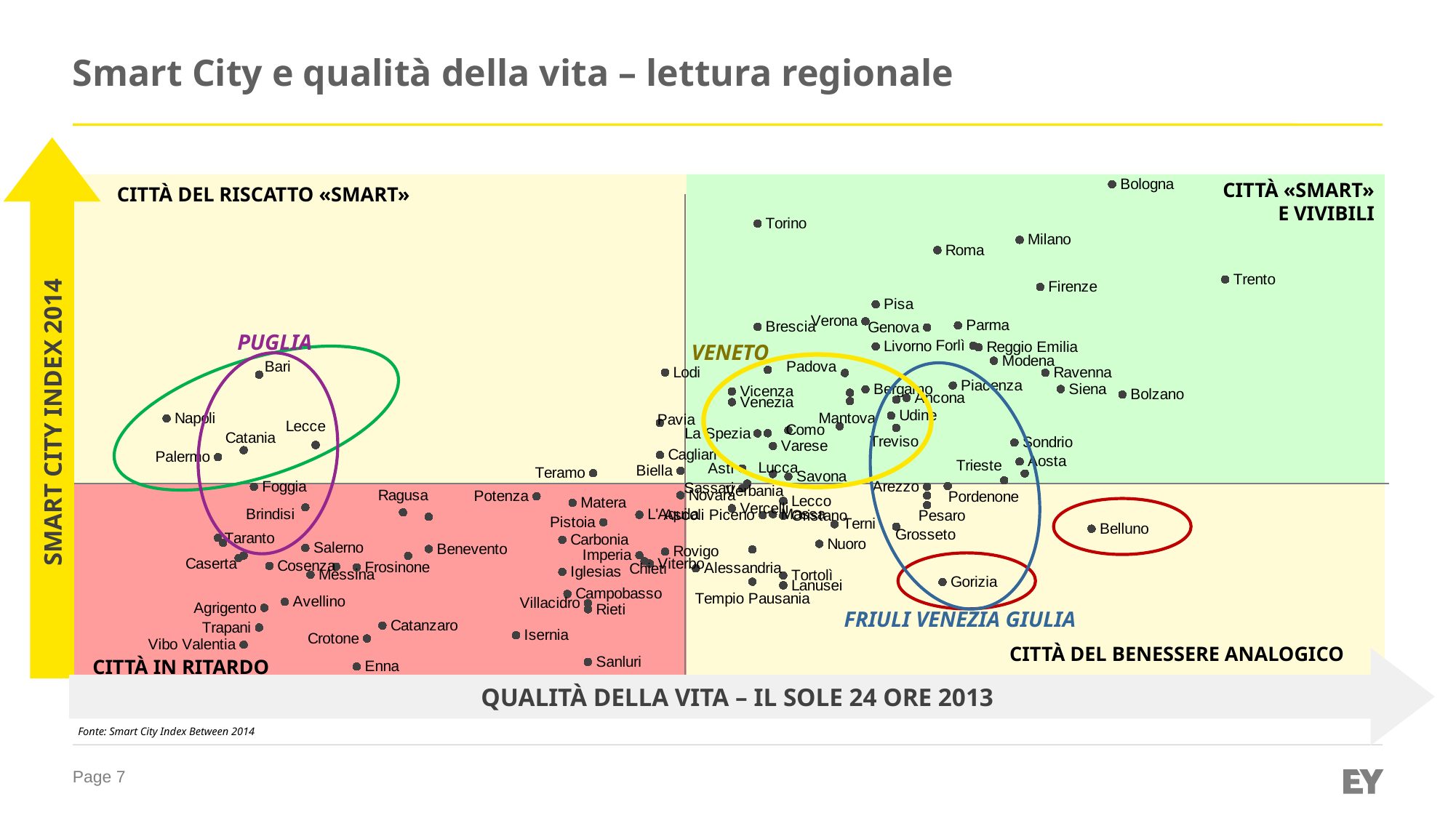
Which city has the higher Smart City Index 2014 value, Bologna or Torino? Bologna Which city is further to the right on the Qualità della vita axis, Trento or Milano? Trento Which city has the higher Smart City Index 2014 value, Bari or Taranto? Bari Which city is positioned furthest to the left on the Qualità della vita axis? Napoli Which region's cities are circled in yellow on the chart? Veneto Which city is positioned furthest to the right on the Qualità della vita axis? Trento What kind of chart is shown on the slide? Scatter plot What is the label of the vertical axis of the chart? SMART CITY INDEX 2014 What is the label of the horizontal axis of the chart? QUALITÀ DELLA VITA – IL SOLE 24 ORE 2013 Which city has the highest Smart City Index 2014 value in the chart? Bologna In which quadrant of the chart is Bologna located? Città «smart» e vivibili In which quadrant of the chart is Enna located? Città in ritardo